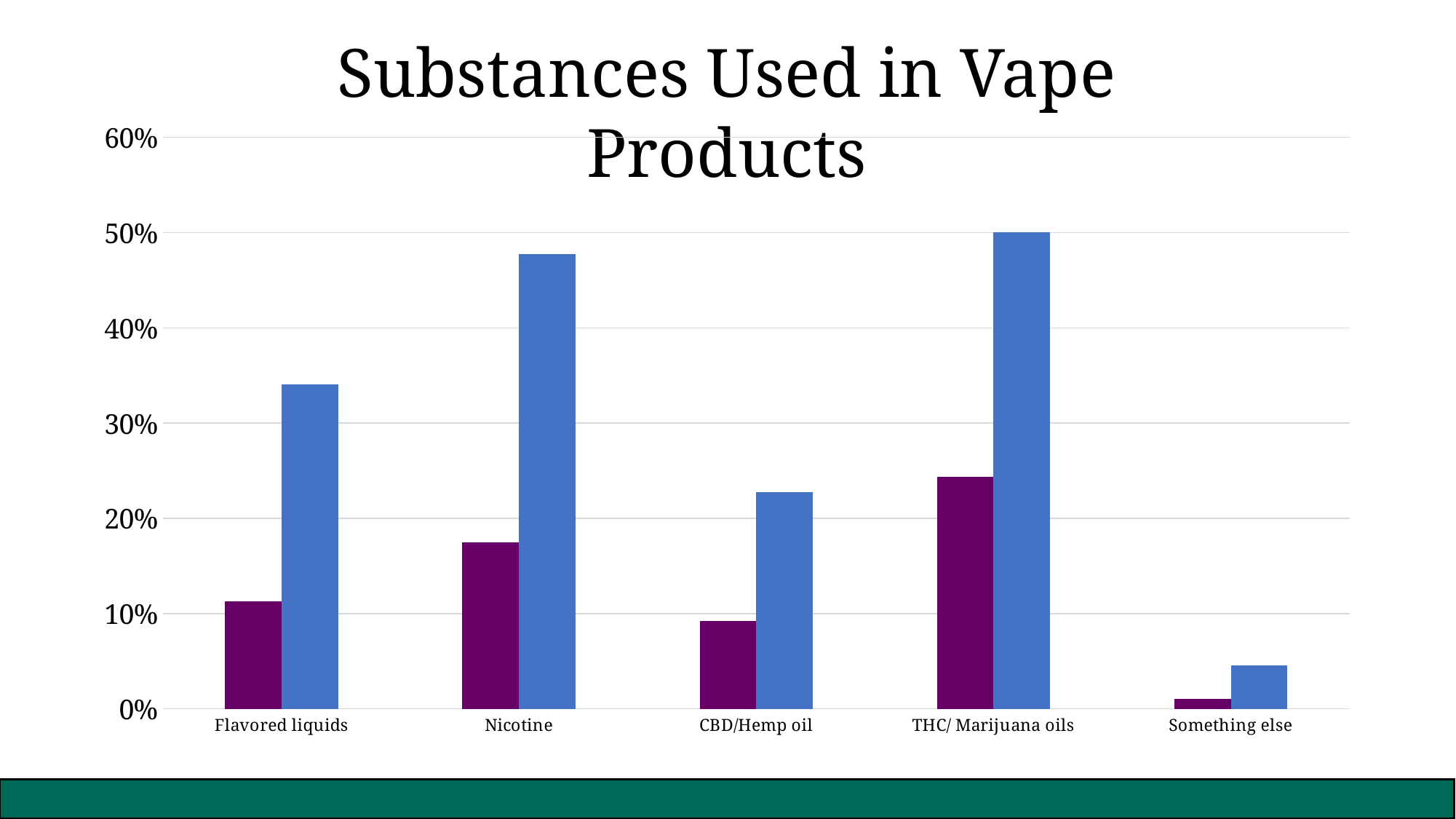
How many bars are plotted for each category? 2 Is the purple bar for THC/ Marijuana oils greater or less than 20%? greater Which category has the highest purple bar? THC/ Marijuana oils Which category has the lowest purple bar? Something else Is the purple bar for CBD/Hemp oil greater or less than 10%? less Which is larger: the purple bar for Nicotine or the purple bar for Flavored liquids? Nicotine What is the title of the chart? Substances Used in Vape Products Which category has the lowest blue bar? Something else How many substance categories are shown on the x axis? 5 Is the blue bar for Nicotine greater or less than 40%? greater Which is larger: the blue bar for Flavored liquids or the blue bar for CBD/Hemp oil? Flavored liquids What kind of chart is shown on the slide? bar chart